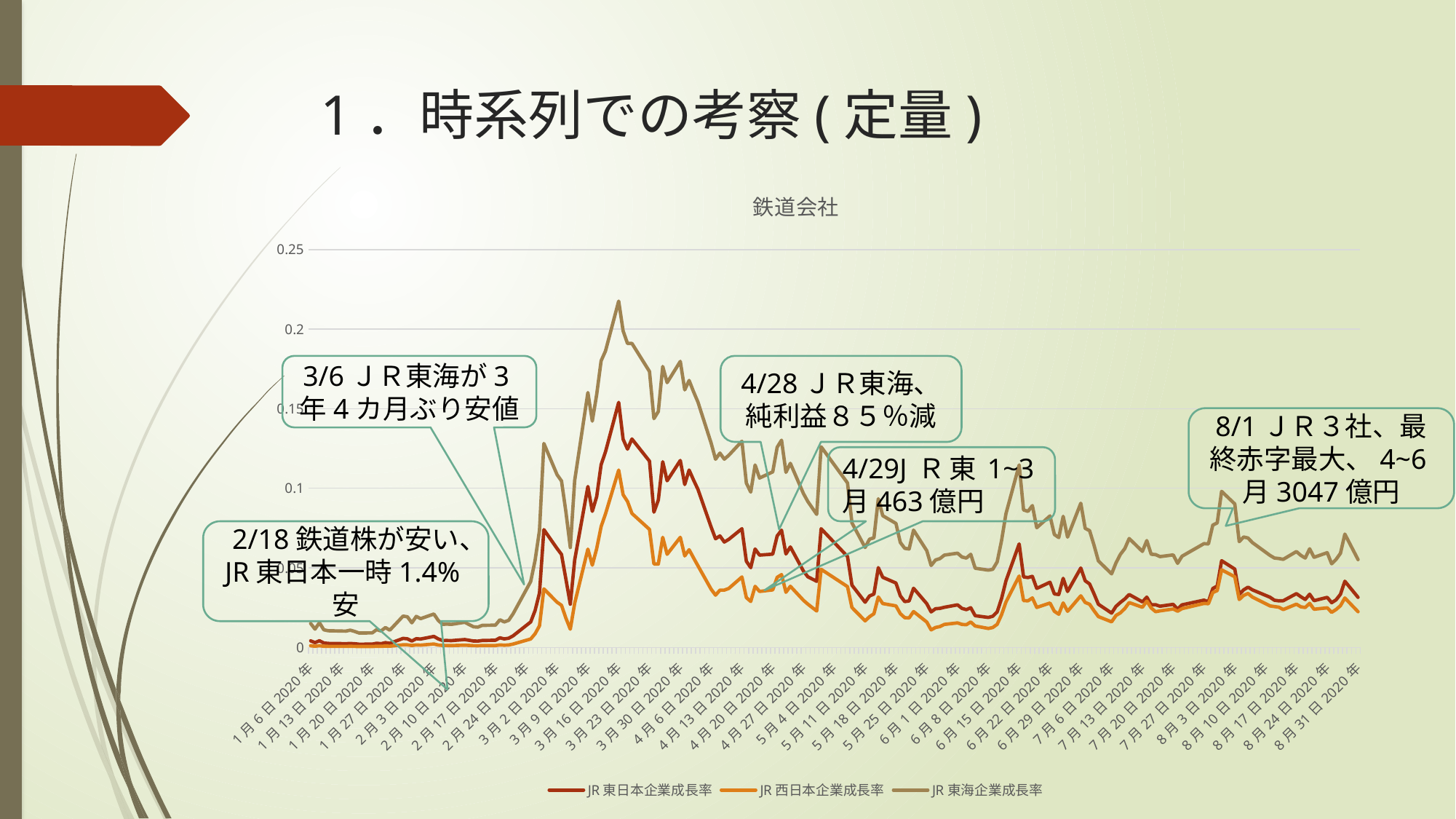
What is the title of the chart? 鉄道会社 What kind of chart is shown on the slide? line chart How many series does the legend list? 3 Is the peak value of JR西日本企業成長率 greater or less than 0.15? less Which series is drawn in orange? JR西日本企業成長率 From 3月23日2020年 to 8月31日2020年, do the values of JR東海企業成長率 generally rise or fall? fall Is the peak value of JR東日本企業成長率 greater or less than 0.2? less Which series reaches the highest peak on the chart? JR東海企業成長率 Is the peak value of JR東海企業成長率 greater or less than 0.2? greater Around 3月23日2020年, which is higher, JR東海企業成長率 or JR西日本企業成長率? JR東海企業成長率 Which series has the lowest peak on the chart? JR西日本企業成長率 From 1月6日2020年 to 3月23日2020年, do the values of JR東海企業成長率 generally rise or fall? rise